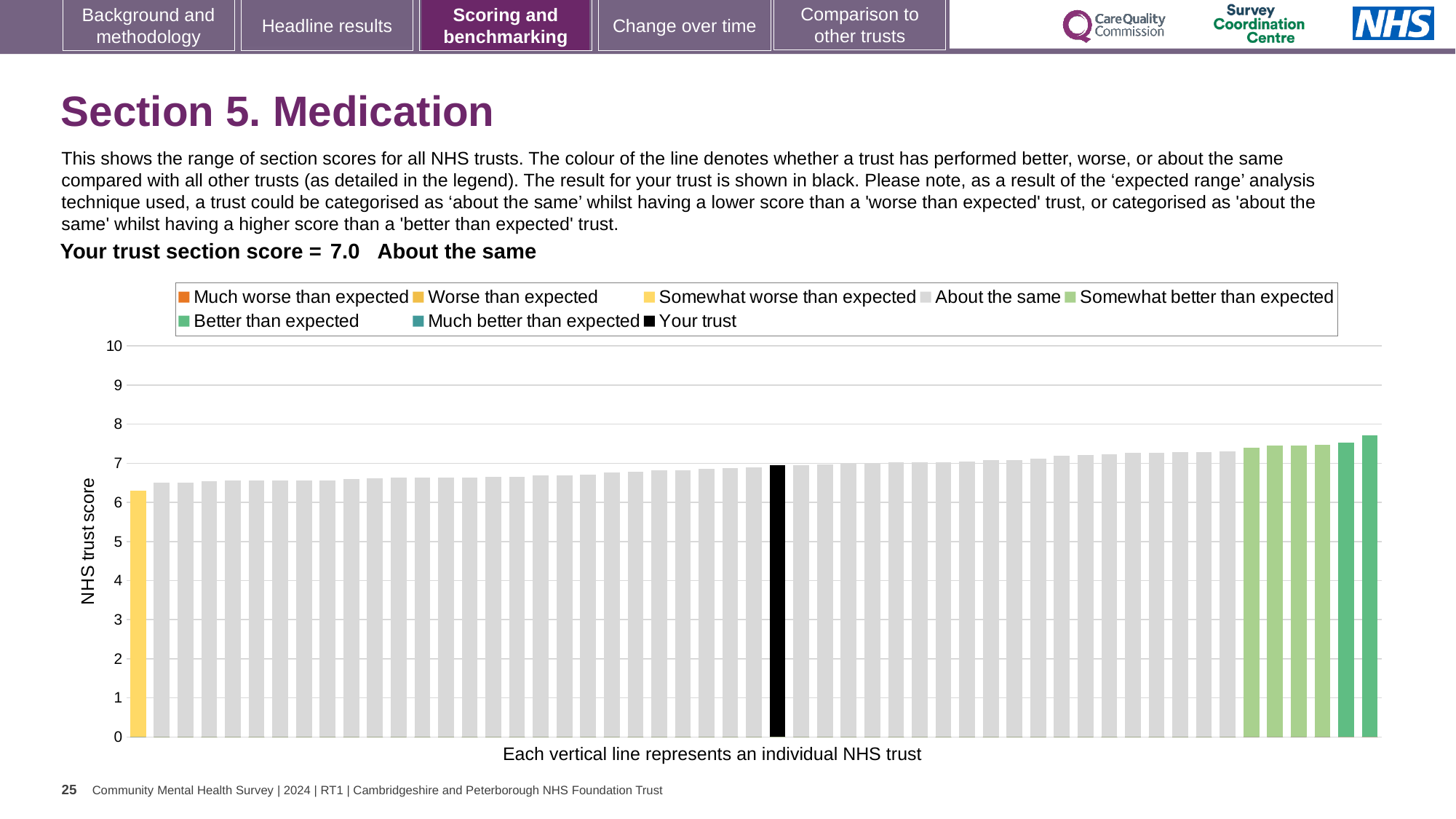
What colour is used for the bar representing your trust? black Do the bar values rise or fall from left to right along the x axis? rise What is the section score for your trust? 7.0 Which performance category is your trust placed in for this section? About the same How many entries does the chart legend list? 8 Is the value for your trust greater or less than 5? greater What is the label on the y axis of the chart? NHS trust score What is the highest value shown on the y axis? 10 What kind of chart is shown on the slide? bar chart Is the value of the shortest bar greater or less than 7? less Is the value of the tallest bar greater or less than 8? less